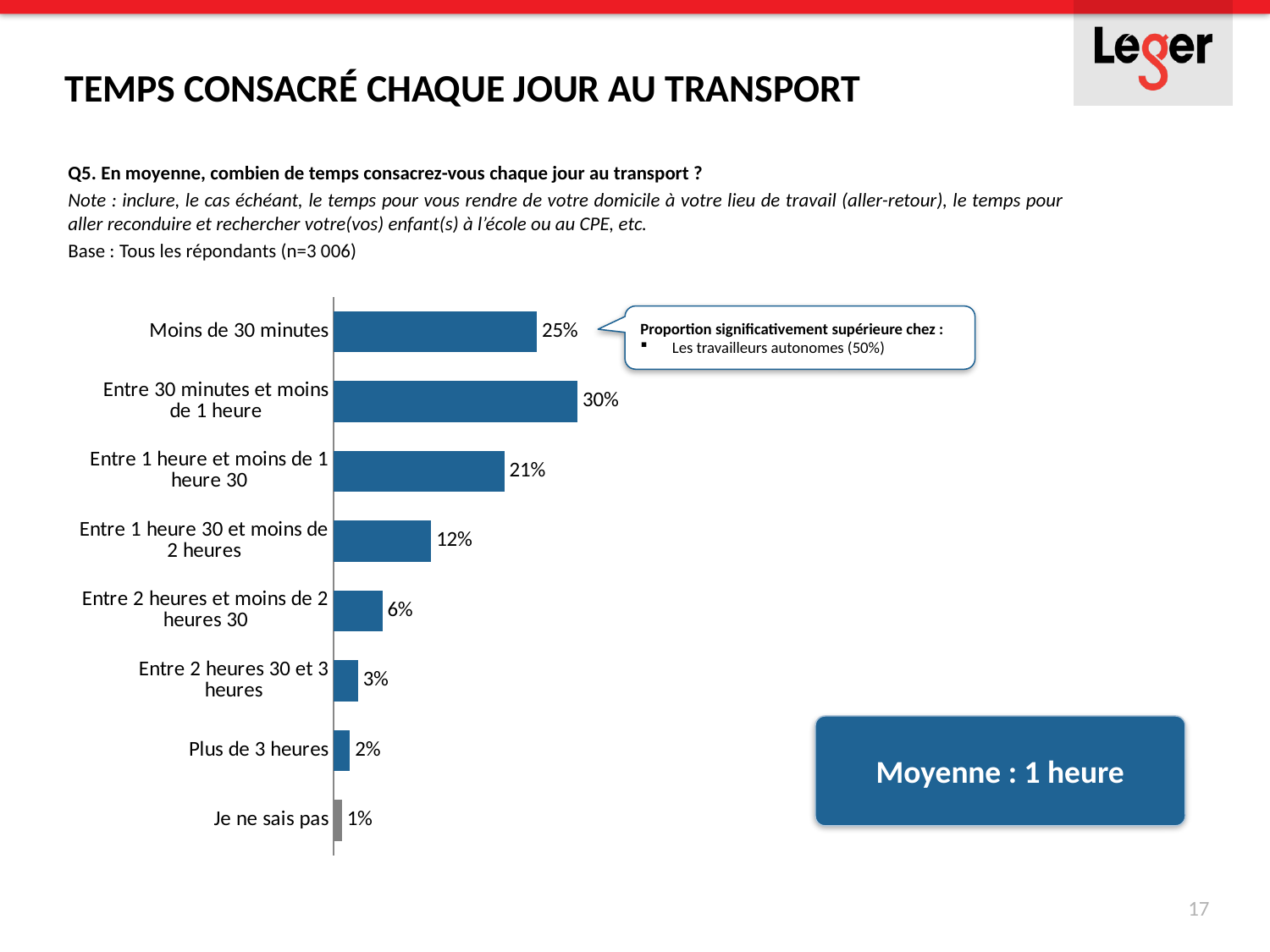
What kind of chart is shown on the slide? Bar chart What average (Moyenne) is stated in the box next to the chart? 1 heure What is the value for "Entre 1 heure et moins de 1 heure 30"? 21% Which category has the lowest value? Je ne sais pas What is the difference between "Entre 1 heure 30 et moins de 2 heures" and "Entre 2 heures et moins de 2 heures 30"? 6% What is the value for "Plus de 3 heures"? 2% What is the value for "Moins de 30 minutes"? 25% What is the value for "Entre 2 heures 30 et 3 heures"? 3% Which is larger: the value for "Entre 1 heure et moins de 1 heure 30" or "Entre 1 heure 30 et moins de 2 heures"? Entre 1 heure et moins de 1 heure 30 Which category has the highest value? Entre 30 minutes et moins de 1 heure What is the difference between "Entre 30 minutes et moins de 1 heure" and "Moins de 30 minutes"? 5% How many categories are shown in the chart? 8